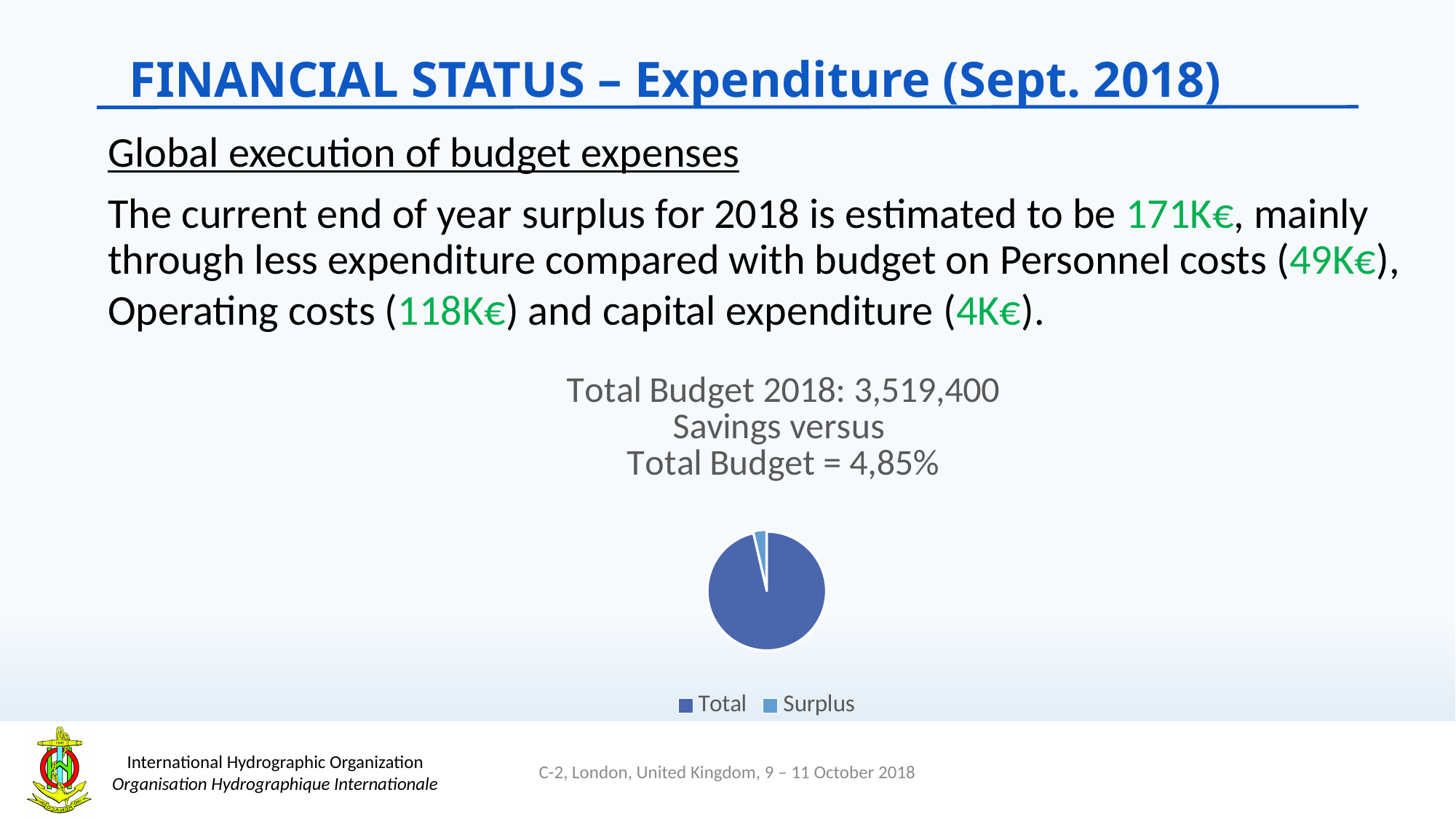
Which slice of the pie chart is the largest? Total How many slices does the pie chart have? 2 In the pie chart, which is larger, the Total slice or the Surplus slice? Total Which slice of the pie chart is the smallest? Surplus What kind of chart is shown on the slide? pie chart How many entries does the legend of the pie chart list? 2 According to the chart title, what is the Total Budget 2018? 3,519,400 What are the two legend entries of the pie chart? Total and Surplus